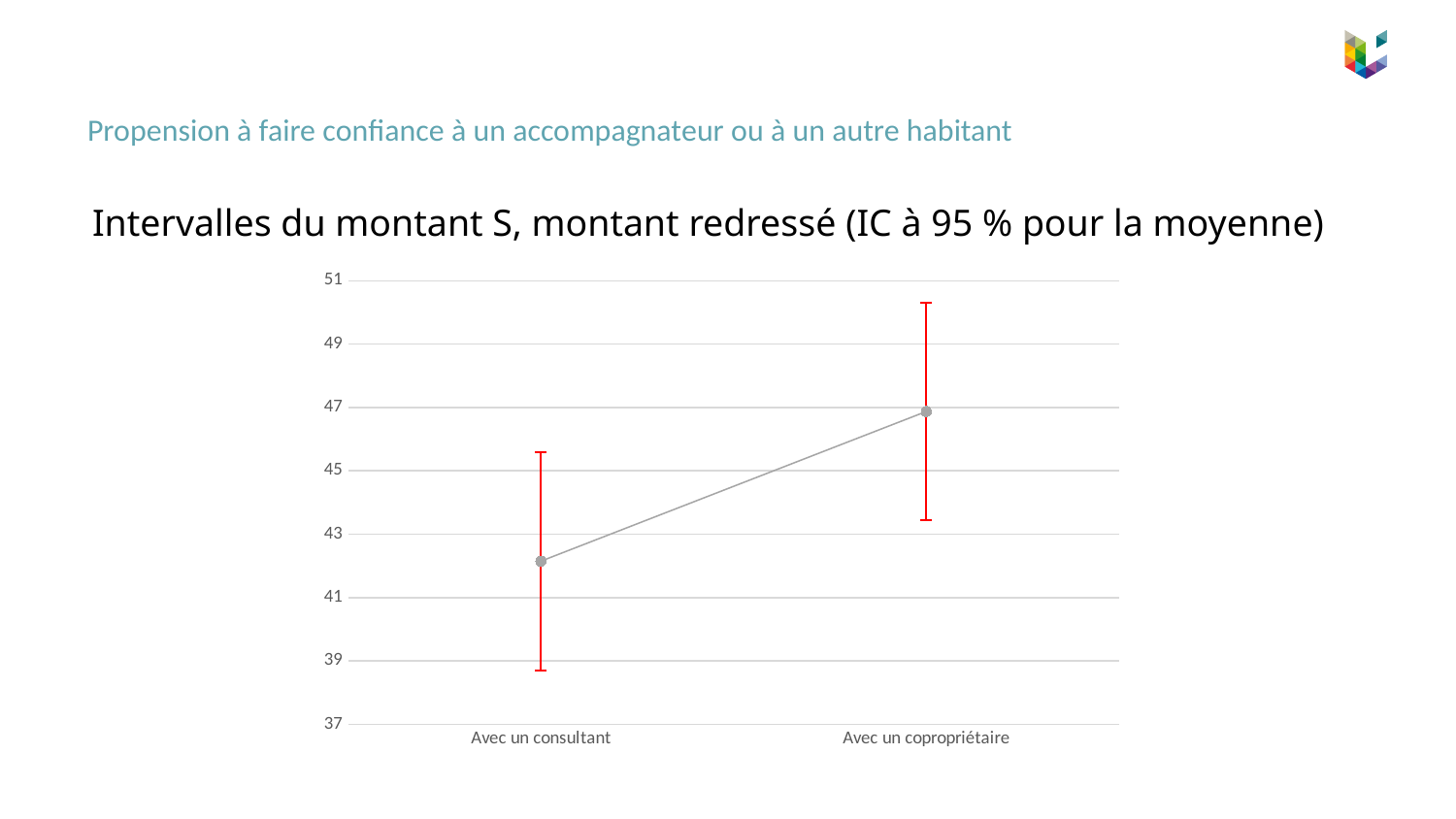
What kind of chart is shown on the slide? line chart Do the plotted values rise or fall from "Avec un consultant" to "Avec un copropriétaire"? rise What is the highest value shown on the chart's vertical axis? 51 Which category has the lowest plotted value? Avec un consultant What is the title of the chart? Intervalles du montant S, montant redressé (IC à 95 % pour la moyenne) Which category has the higher plotted value, "Avec un consultant" or "Avec un copropriétaire"? Avec un copropriétaire Which category has the highest plotted value? Avec un copropriétaire How many categories are plotted on the x axis of the chart? 2 Is the plotted value for "Avec un copropriétaire" greater or less than 45? greater Is the plotted value for "Avec un consultant" greater or less than 41? greater Is the plotted value for "Avec un consultant" greater or less than 43? less